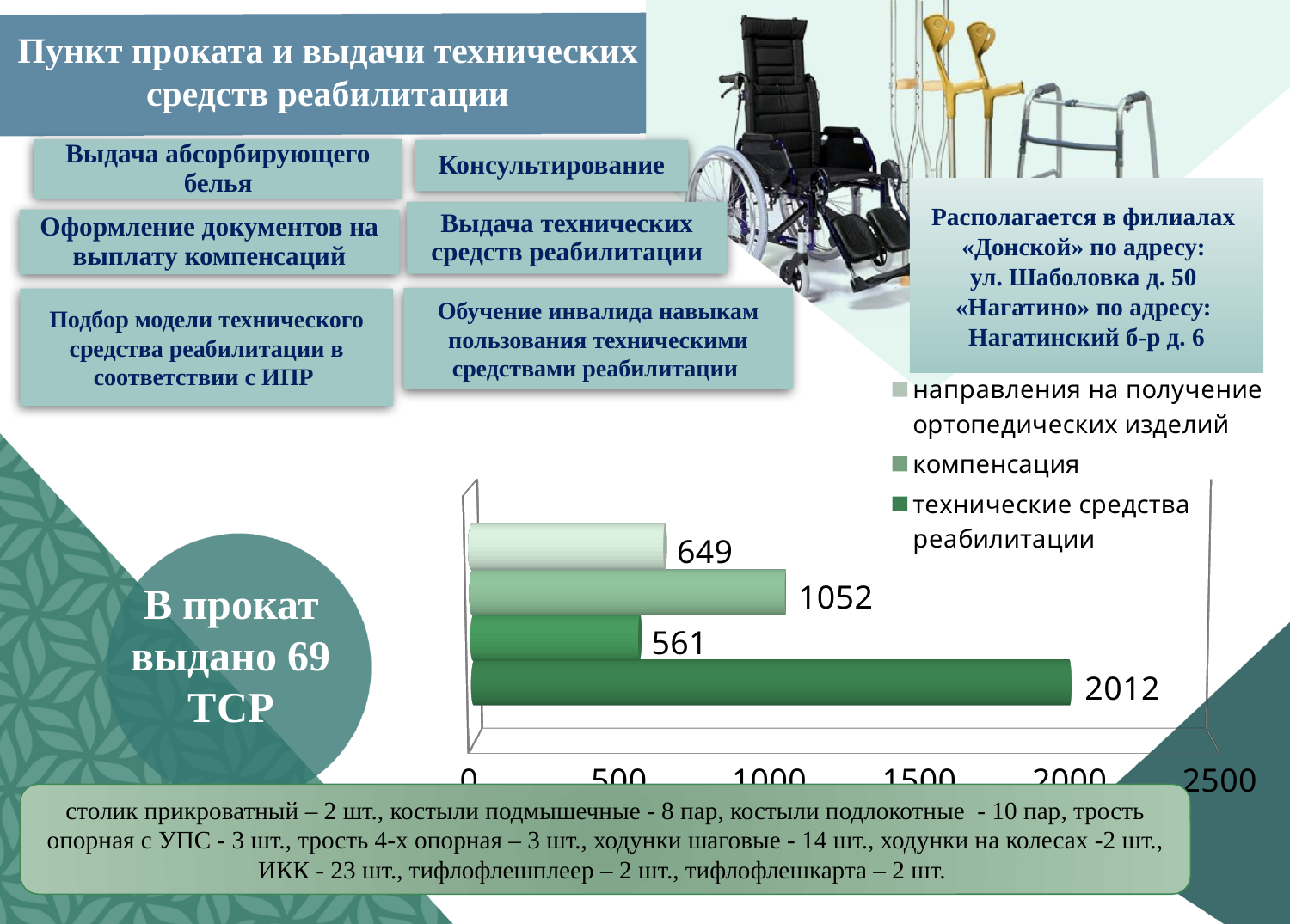
What is the value of the topmost bar in the chart? 649 Which is larger: the topmost bar or the third bar from the top? the topmost bar (649) How many entries does the chart legend list? 3 Is the value of the bottom bar greater or less than 1500? greater What is the lowest value shown in the chart? 561 What is the difference between the bar labelled 1052 and the bar labelled 649? 403 How many bars are plotted in the chart? 4 What is the highest value shown in the chart? 2012 What is the maximum value shown on the chart's horizontal axis? 2500 What is the value of the bottom (longest) bar in the chart? 2012 What is the difference between the largest bar (2012) and the smallest bar (561)? 1451 What kind of chart is shown on the slide? bar chart